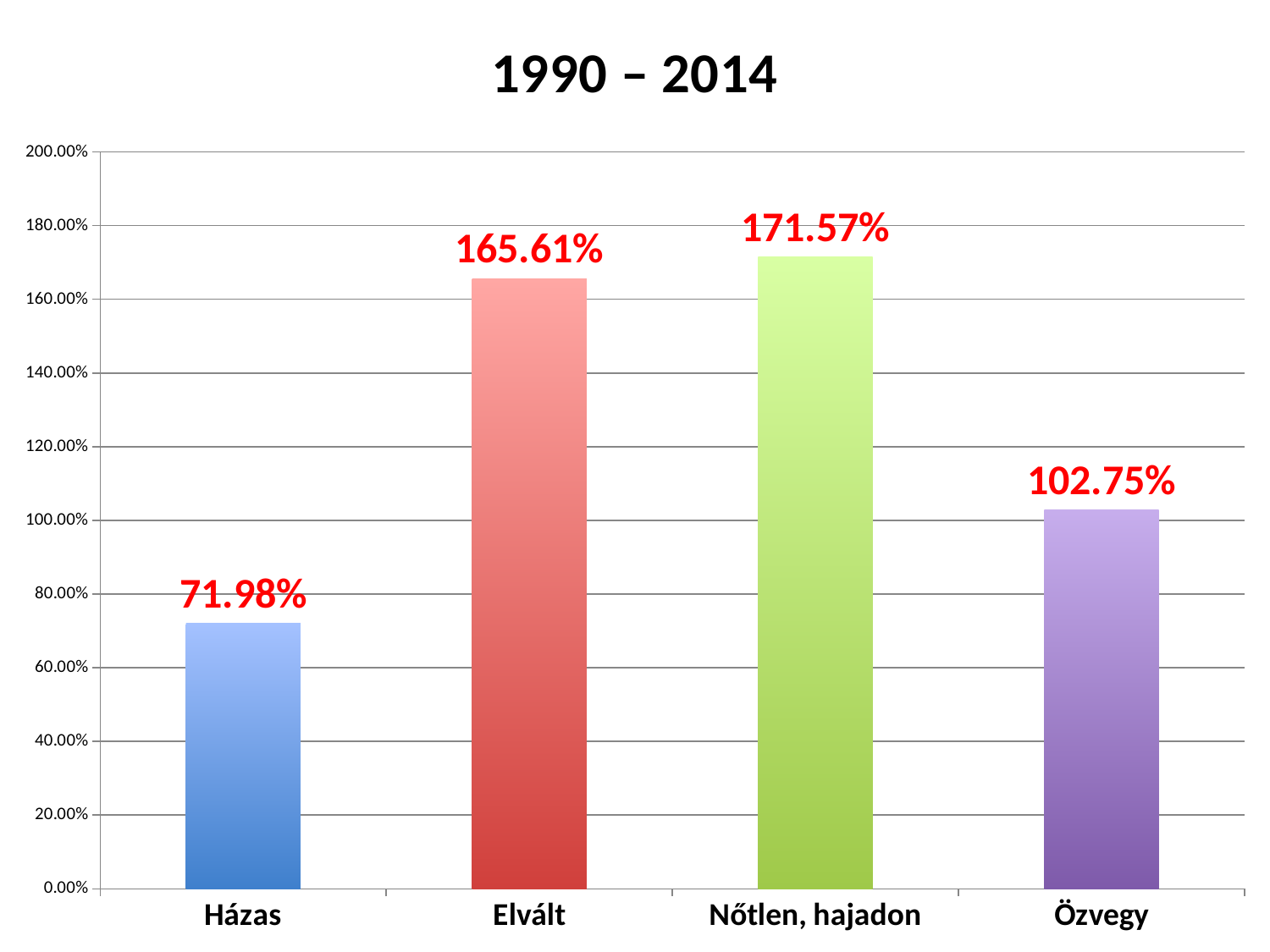
What kind of chart is shown on the slide? bar chart What is the value for Elvált? 165.61% Which is larger, the value for Elvált or the value for Özvegy? Elvált What is the difference between the values for Nőtlen, hajadon and Elvált? 5.96% What is the value for Nőtlen, hajadon? 171.57% What is the value for Házas? 71.98% How many categories are shown on the chart? 4 What is the value for Özvegy? 102.75% Is the value for Házas greater or less than 80.00%? less Which category has the highest value? Nőtlen, hajadon Which category has the lowest value? Házas What is the difference between the values for Özvegy and Házas? 30.77%